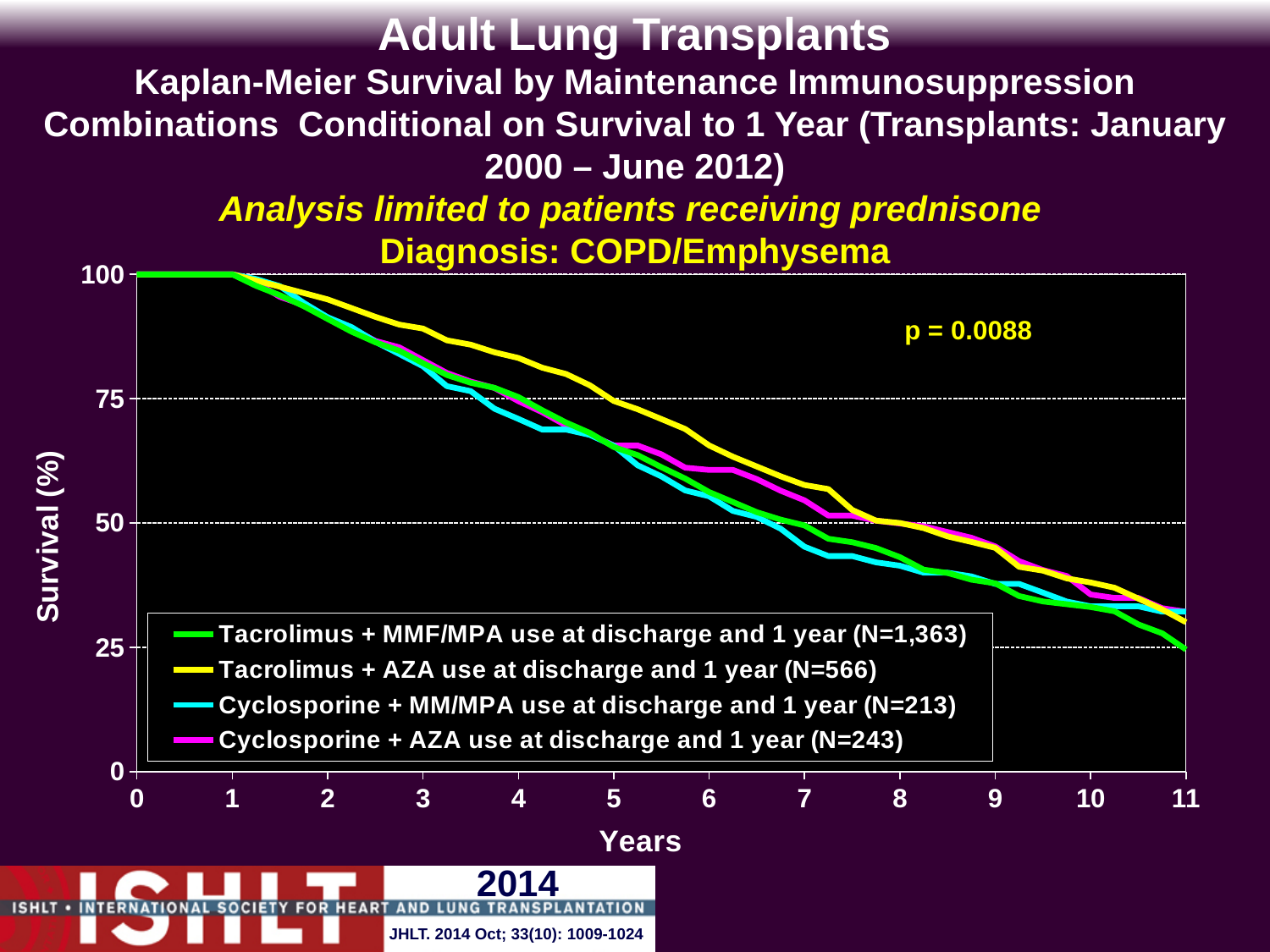
At year 7, which group has higher survival: Tacrolimus + AZA or Cyclosporine + MM/MPA? Tacrolimus + AZA Which group has the highest survival at year 4? Tacrolimus + AZA use at discharge and 1 year (N=566) Which group has the lowest survival at year 11? Tacrolimus + MMF/MPA use at discharge and 1 year (N=1,363) What is the survival (%) for all four groups at year 0? 100 How many series does the legend list? 4 Do the survival curves rise or fall as years increase? fall Is the survival for Tacrolimus + AZA at year 4 greater or less than 75? greater What kind of chart is shown on the slide? line chart Is the survival for Tacrolimus + MMF/MPA at year 8 greater or less than 50? less Is the survival for Tacrolimus + AZA at year 11 greater or less than 25? greater What p-value is shown on the chart? p = 0.0088